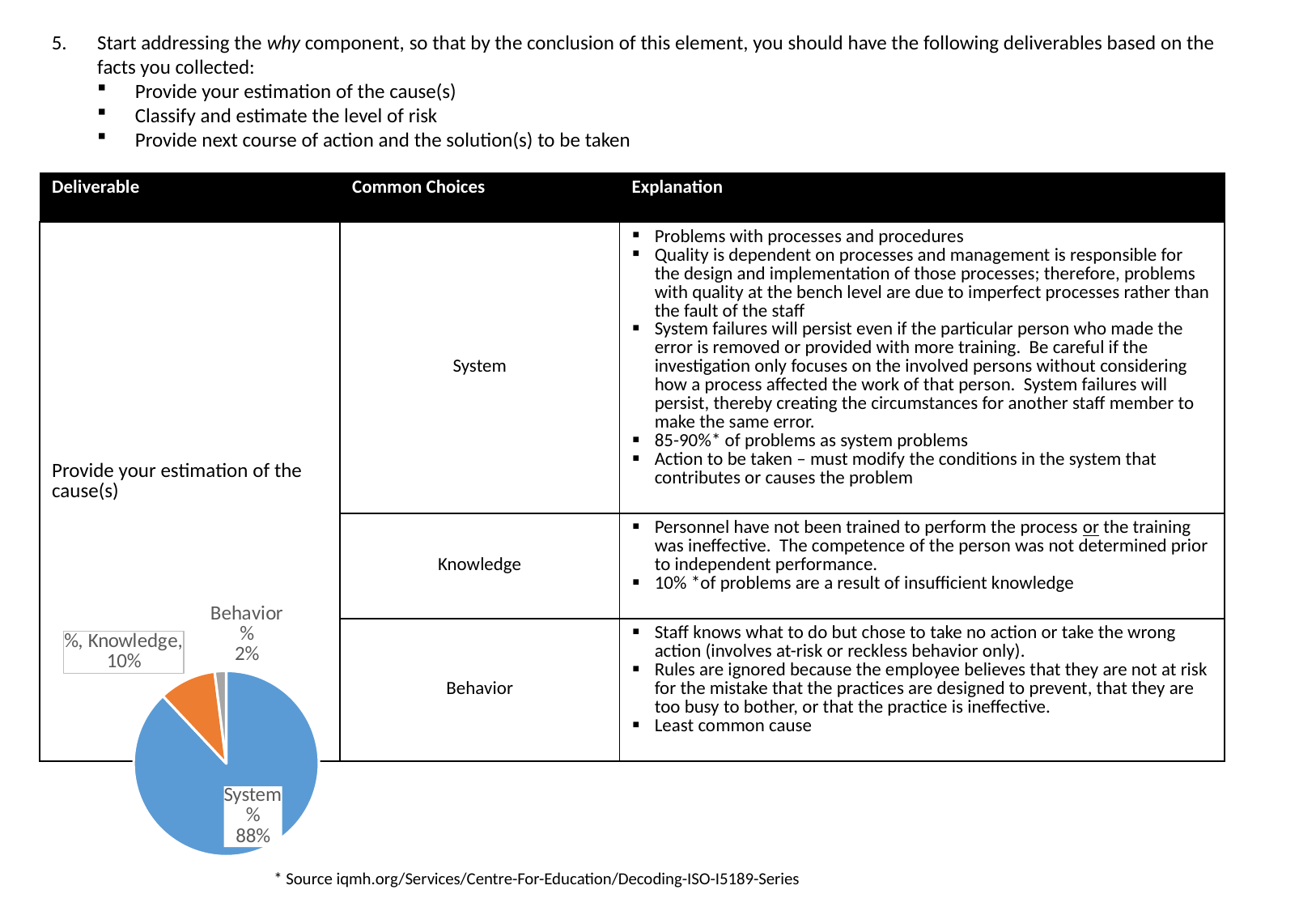
What percentage of the pie chart is the Knowledge slice? 10% What kind of chart is shown on the slide? pie chart How many slices does the pie chart have? 3 What is the combined share of the Knowledge and Behavior slices in the pie chart? 12% What is the difference in percentage points between the System slice and the Knowledge slice? 78 What percentage of the pie chart is the System slice? 88% Which slice of the pie chart is the smallest? Behavior Which slice of the pie chart is the largest? System What colour is the System slice in the pie chart? blue What is the difference in percentage points between the Knowledge slice and the Behavior slice? 8 What percentage of the pie chart is the Behavior slice? 2% Which is larger in the pie chart, the Knowledge slice or the Behavior slice? Knowledge